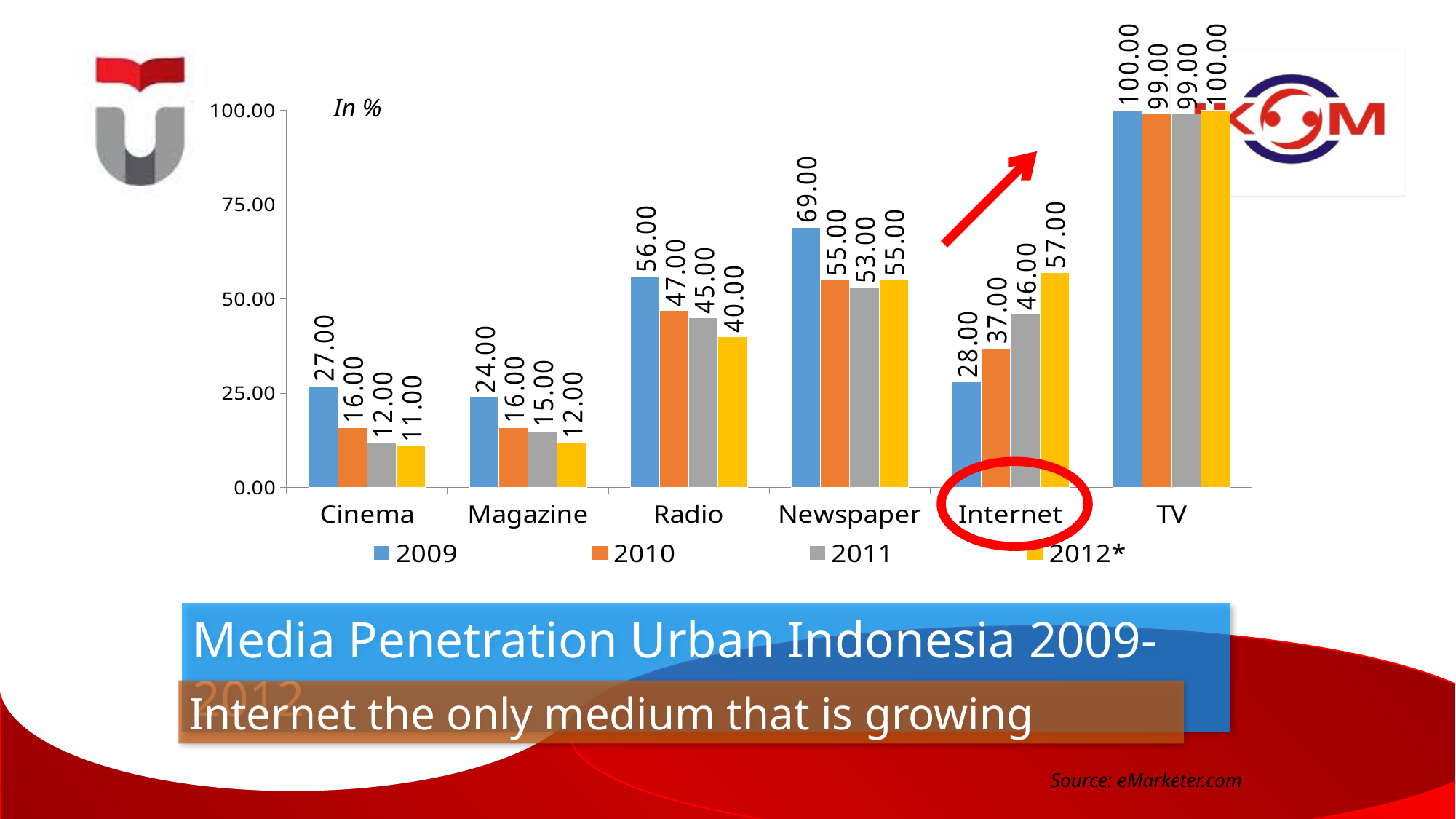
Do the values for Magazine rise or fall from 2009 to 2012*? Fall What is the value for Radio in 2009? 56.00 Which category has the lowest value in 2012*? Cinema What is the value for Cinema in 2011? 12.00 What is the difference between the Internet values for 2012* and 2009? 29.00 Which category has the highest value in 2009? TV What is the value for Internet in 2012*? 57.00 What kind of chart is shown on the slide? Bar chart How many series does the legend list? 4 How many categories are shown on the x axis? 6 Which category on the x axis is circled in red? Internet Which is larger, the 2010 value for Radio or the 2010 value for Newspaper? Newspaper